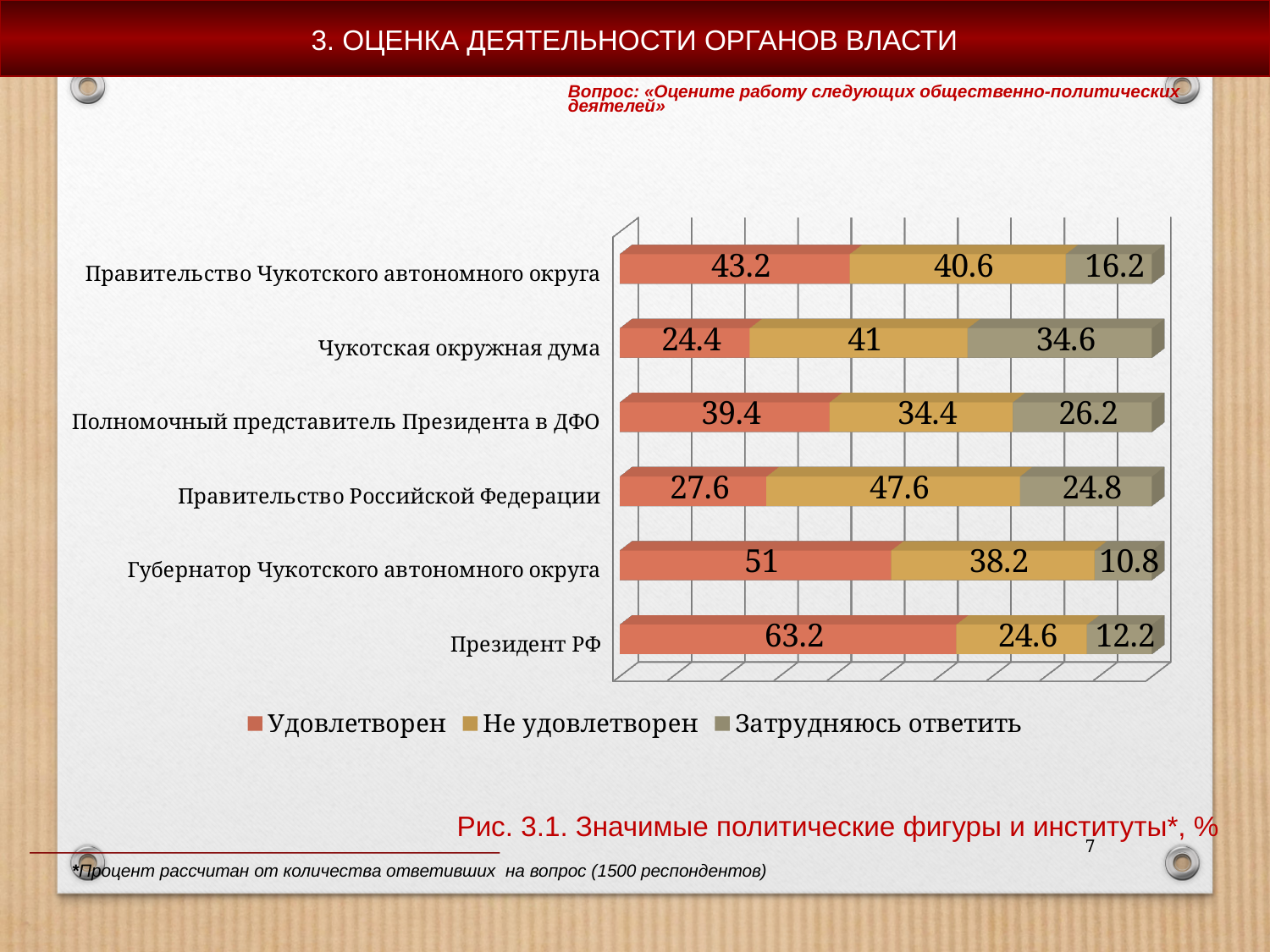
Which category has the highest "Удовлетворен" value? Президент РФ What kind of chart is shown on the slide? Stacked bar chart How many series does the legend list? 3 What is the "Удовлетворен" value for Президент РФ? 63.2 Which category has the lowest "Затрудняюсь ответить" value? Губернатор Чукотского автономного округа How many categories are shown on the chart? 6 What is the "Затрудняюсь ответить" value for Чукотская окружная дума? 34.6 What is the difference between the "Удовлетворен" values for Президент РФ and Губернатор Чукотского автономного округа? 12.2 Which is larger: the "Не удовлетворен" value for Чукотская окружная дума or for Полномочный представитель Президента в ДФО? Чукотская окружная дума What is the "Не удовлетворен" value for Правительство Российской Федерации? 47.6 What is the total of the stacked bar for Правительство Чукотского автономного округа? 100 What is the caption of the figure below the chart? Рис. 3.1. Значимые политические фигуры и институты*, %